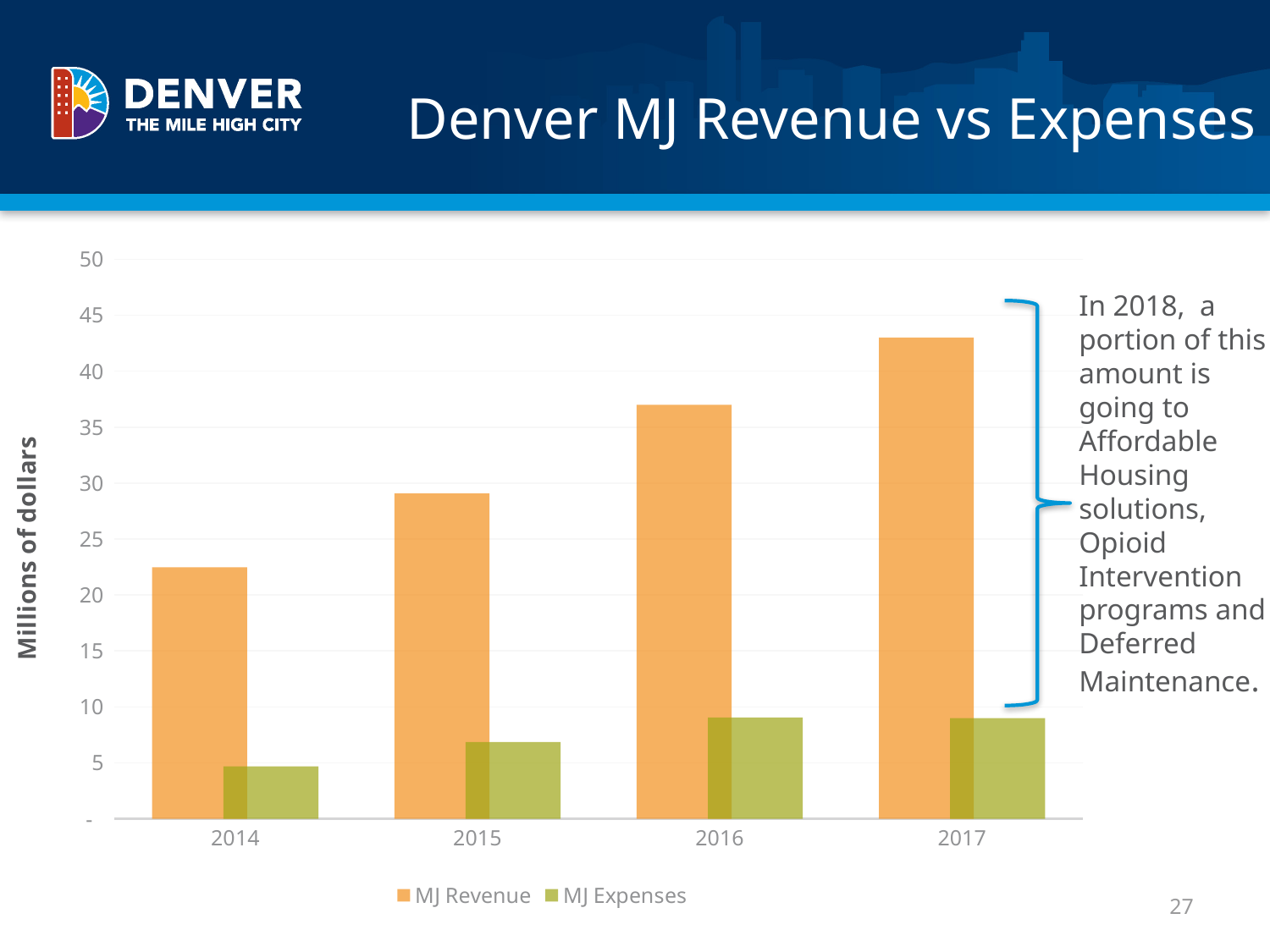
Does MJ Revenue rise or fall from 2014 to 2017? rise Which year has the lowest MJ Expenses? 2014 What is the label on the vertical axis? Millions of dollars Which is larger in 2016, MJ Revenue or MJ Expenses? MJ Revenue What kind of chart is shown on the slide? bar chart Is the MJ Revenue for 2014 greater or less than 25? less Which year has the lowest MJ Revenue? 2014 How many series does the legend list? 2 Is the MJ Revenue for 2017 greater or less than 40? greater Which year has the highest MJ Revenue? 2017 How many years are shown on the x axis? 4 Is the MJ Expenses value for 2015 greater or less than 10? less